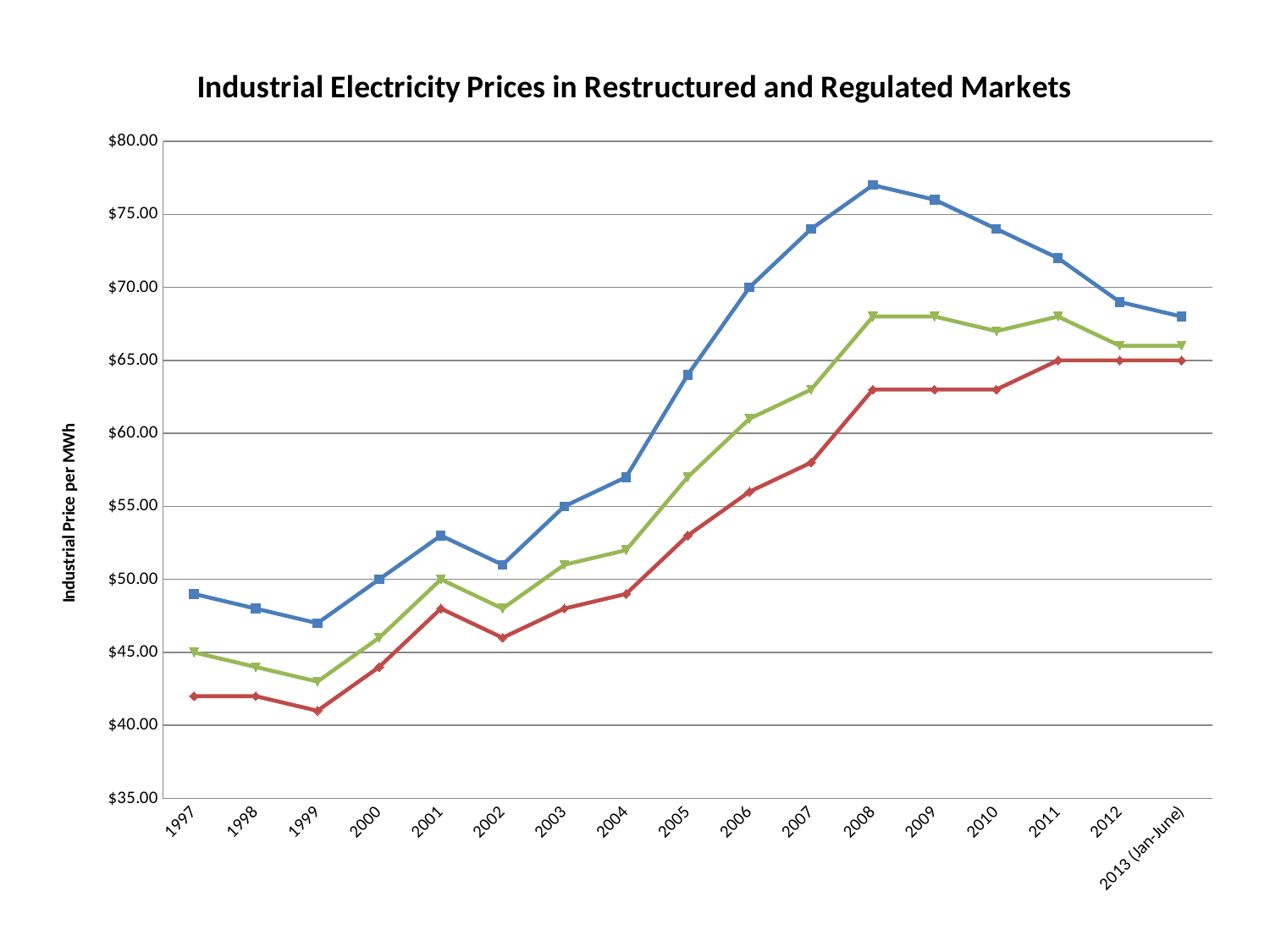
How many years (x-axis categories) are plotted on the chart? 17 In which year does the red line reach its lowest value? 1999 In 2008, which line has the higher value, the blue line or the red line? the blue line What is the value of the red line in 2011? $65.00 What is the value of the blue line in 2006? $70.00 What kind of chart is shown on the slide? line chart Is the value of the blue line in 2008 greater or less than $75.00? greater What is the value of the green line in 1997? $45.00 What is the value of the blue line in 2000? $50.00 In which year does the blue line reach its highest value? 2008 Does the blue line rise or fall between 2008 and 2013 (Jan-June)? fall Is the value of the red line in 1999 greater or less than $45.00? less